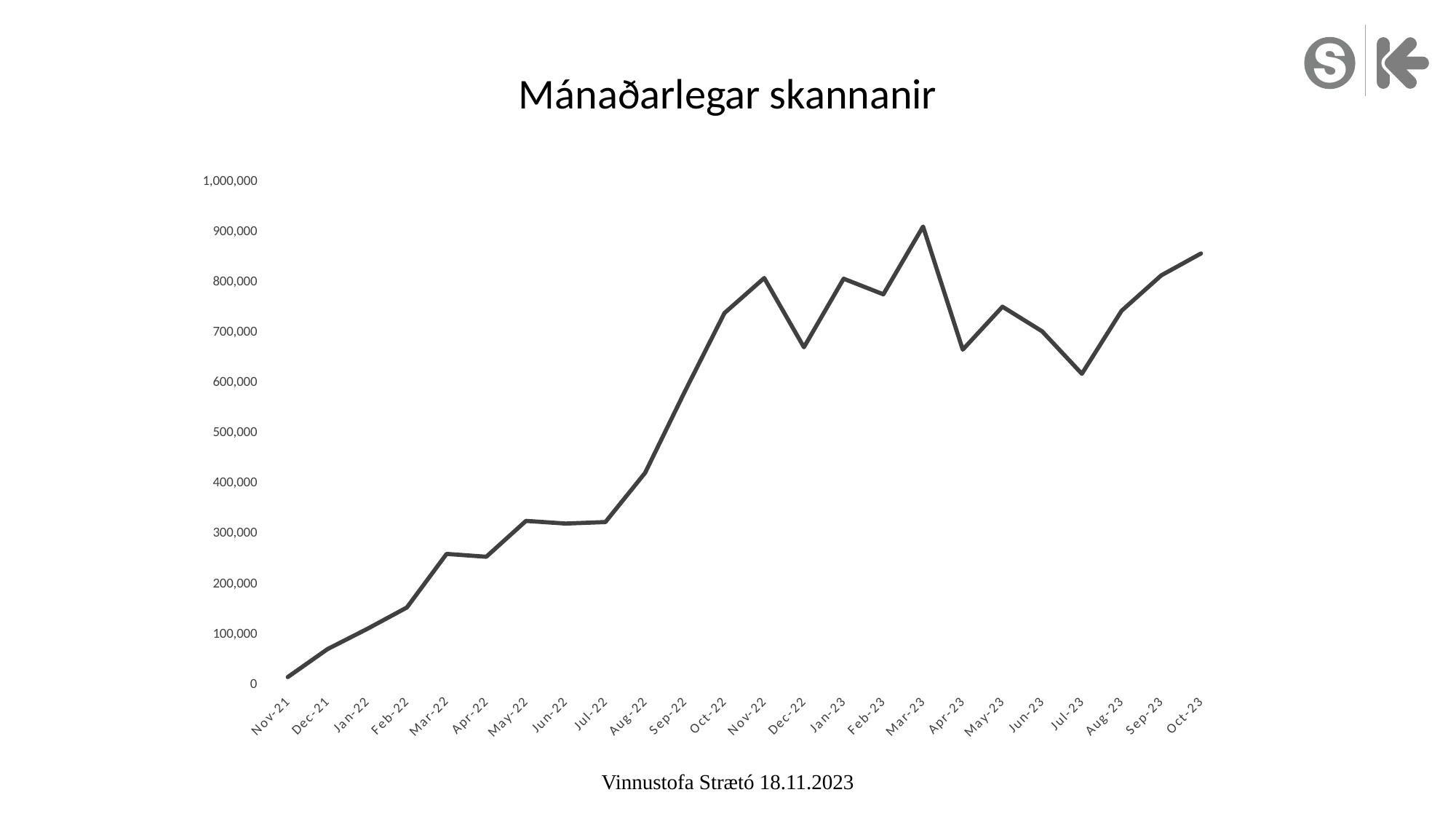
What is the title of the chart? Mánaðarlegar skannanir How many months are plotted along the x axis? 24 Is the value for Mar-23 greater or less than 800,000? greater What kind of chart is shown on the slide? line chart Overall, do the values rise or fall from Nov-21 to Oct-23? rise Which month has the lowest value? Nov-21 Is the value for Apr-23 greater or less than 700,000? less Is the value for Oct-23 greater or less than 800,000? greater Which month has the highest value? Mar-23 Which is larger, the value for Nov-22 or the value for Dec-22? Nov-22